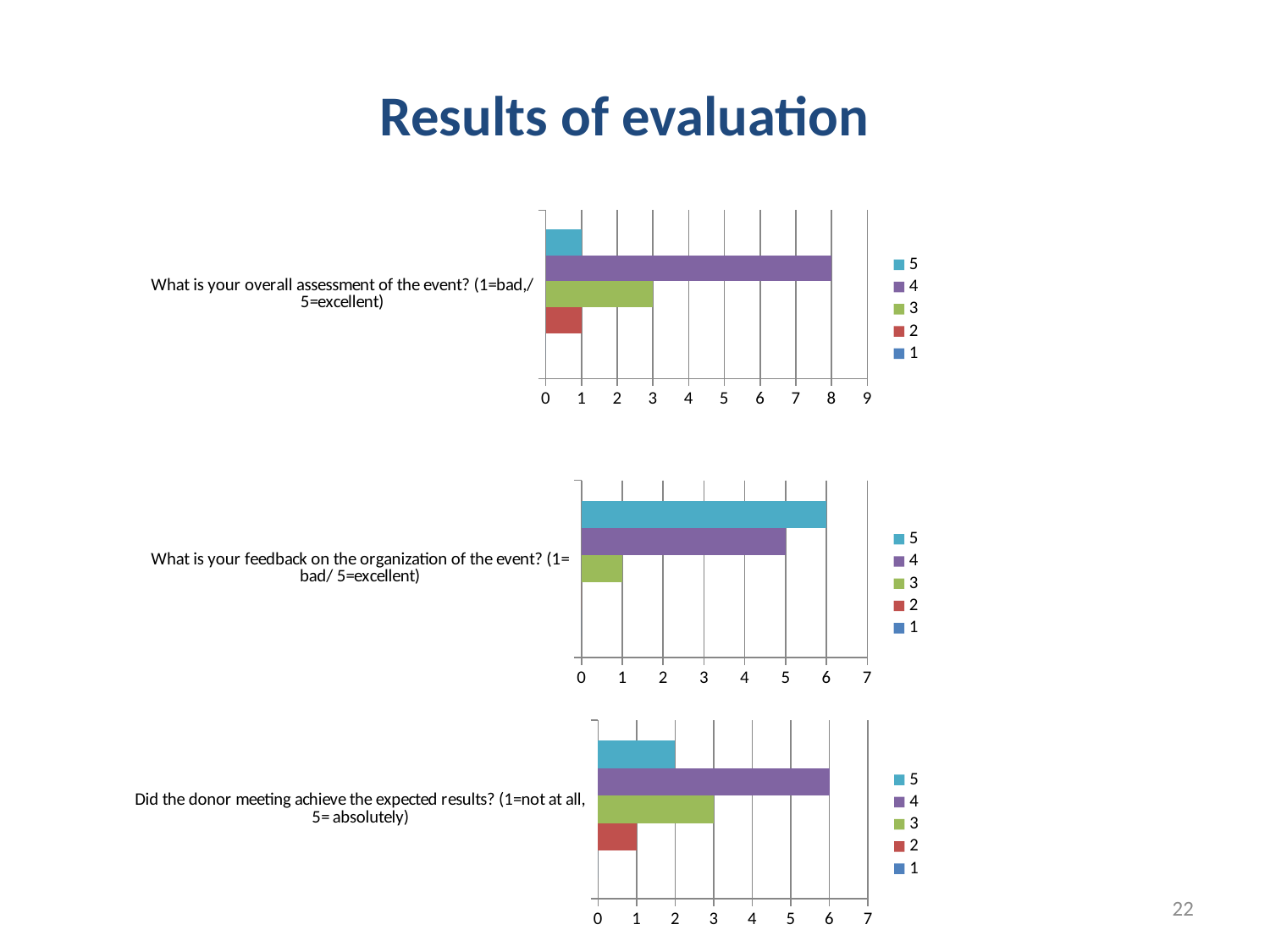
In the bottom chart (did the donor meeting achieve the expected results), what is the value for series 4? 6 What is the title of the slide? Results of evaluation In the top chart (overall assessment of the event), which series has the highest value? 4 In the top chart (overall assessment of the event), what is the value for series 3? 3 In the middle chart (feedback on the organization of the event), what is the difference between the values for series 5 and series 4? 1 In the bottom chart (did the donor meeting achieve the expected results), what is the difference between the values for series 4 and series 5? 4 In the middle chart (feedback on the organization of the event), what is the value for series 3? 1 What kind of chart is the middle chart (feedback on the organization of the event)? bar chart How many series does the legend of the top chart list? 5 In the bottom chart (did the donor meeting achieve the expected results), which is larger, the value for series 5 or the value for series 3? 3 In the top chart (overall assessment of the event), what is the value for series 4? 8 In the middle chart (feedback on the organization of the event), what is the value for series 5? 6